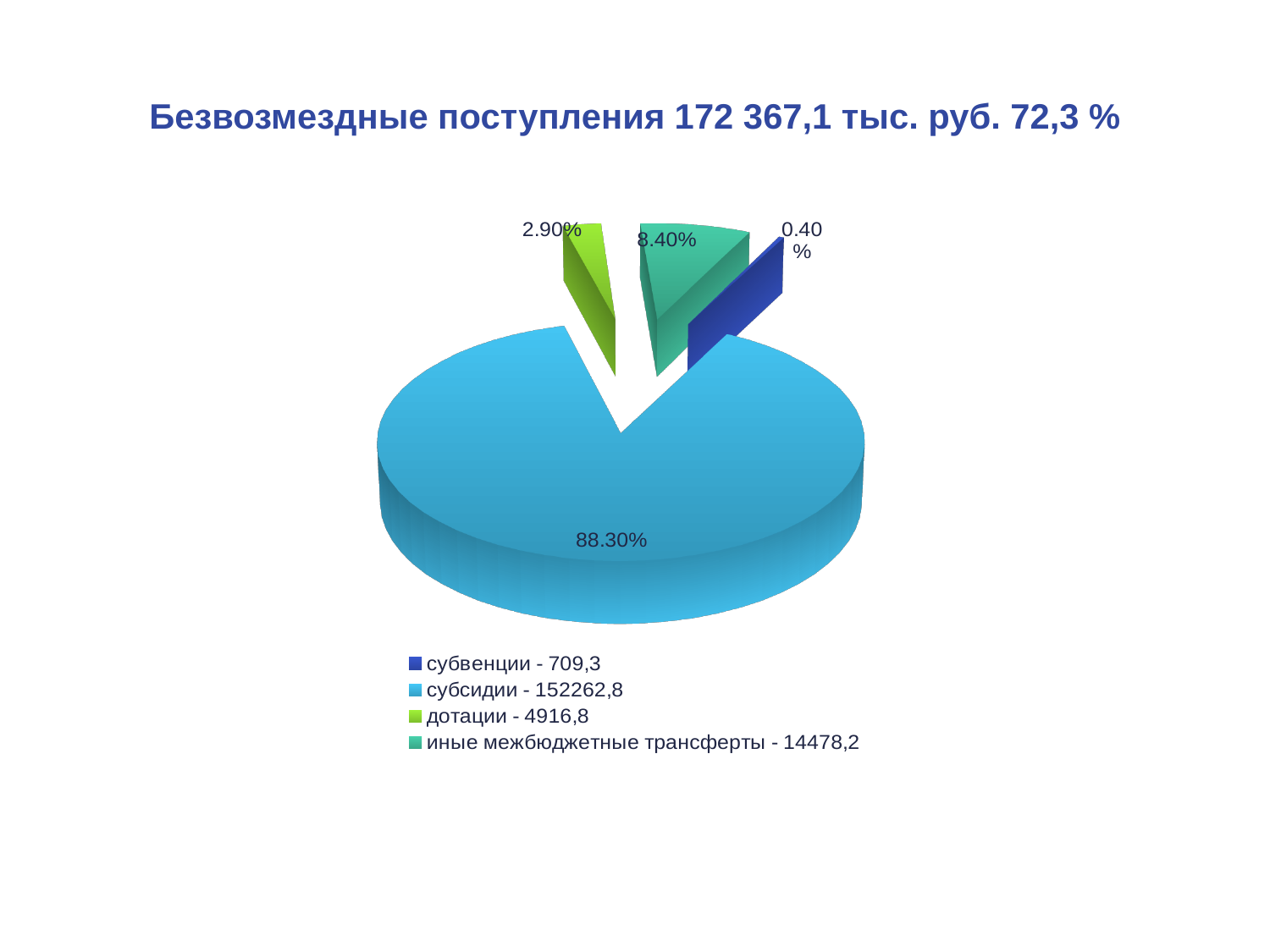
What kind of chart is shown on the slide? pie chart What share of the pie does субвенции take? 0.40% How many slices does the pie chart have? 4 What share of the pie does дотации take? 2.90% Which category has the smallest slice of the pie? субвенции Which category has the largest slice of the pie? субсидии What value is listed in the legend for дотации? 4916,8 Which slice is larger: дотации or иные межбюджетные трансферты? иные межбюджетные трансферты What share of the pie does иные межбюджетные трансферты take? 8.40% What is the difference in percentage points between the субсидии slice and the иные межбюджетные трансферты slice? 79.90% What is the title of the chart? Безвозмездные поступления 172 367,1 тыс. руб. 72,3 %